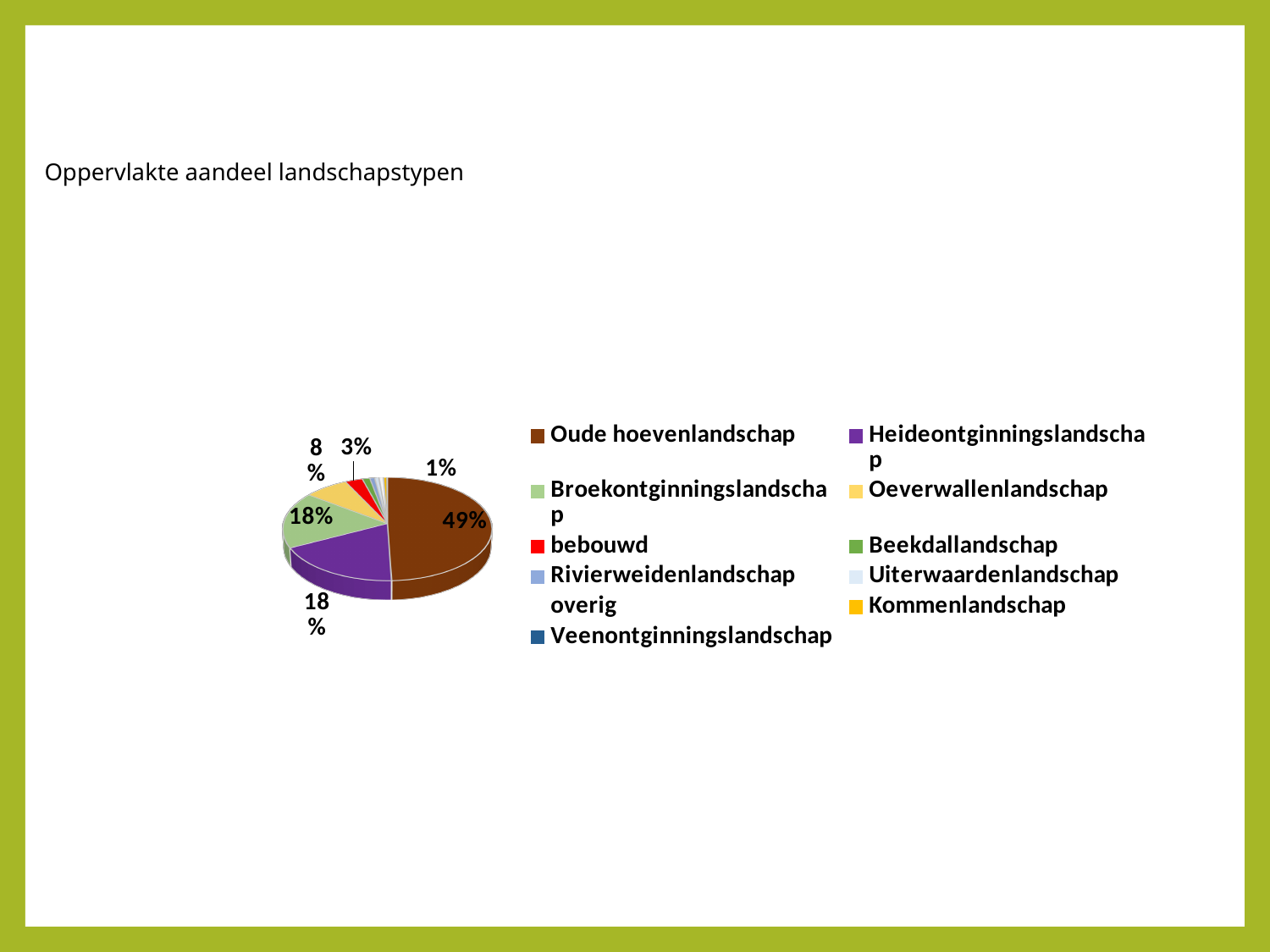
What is the title of the chart? Oppervlakte aandeel landschapstypen Which landscape type has the largest share of the pie? Oude hoevenlandschap How many percentage points larger is the share of Oude hoevenlandschap than that of Heideontginningslandschap? 31 How many landscape types does the legend list? 11 What share of the pie does Oeverwallenlandschap have? 8% What share of the pie does Broekontginningslandschap have? 18% What share of the pie does Oude hoevenlandschap have? 49% How many percentage points larger is the share of Broekontginningslandschap than that of Oeverwallenlandschap? 10 Which has the larger share, Oeverwallenlandschap or bebouwd? Oeverwallenlandschap What kind of chart is shown on the slide? pie chart